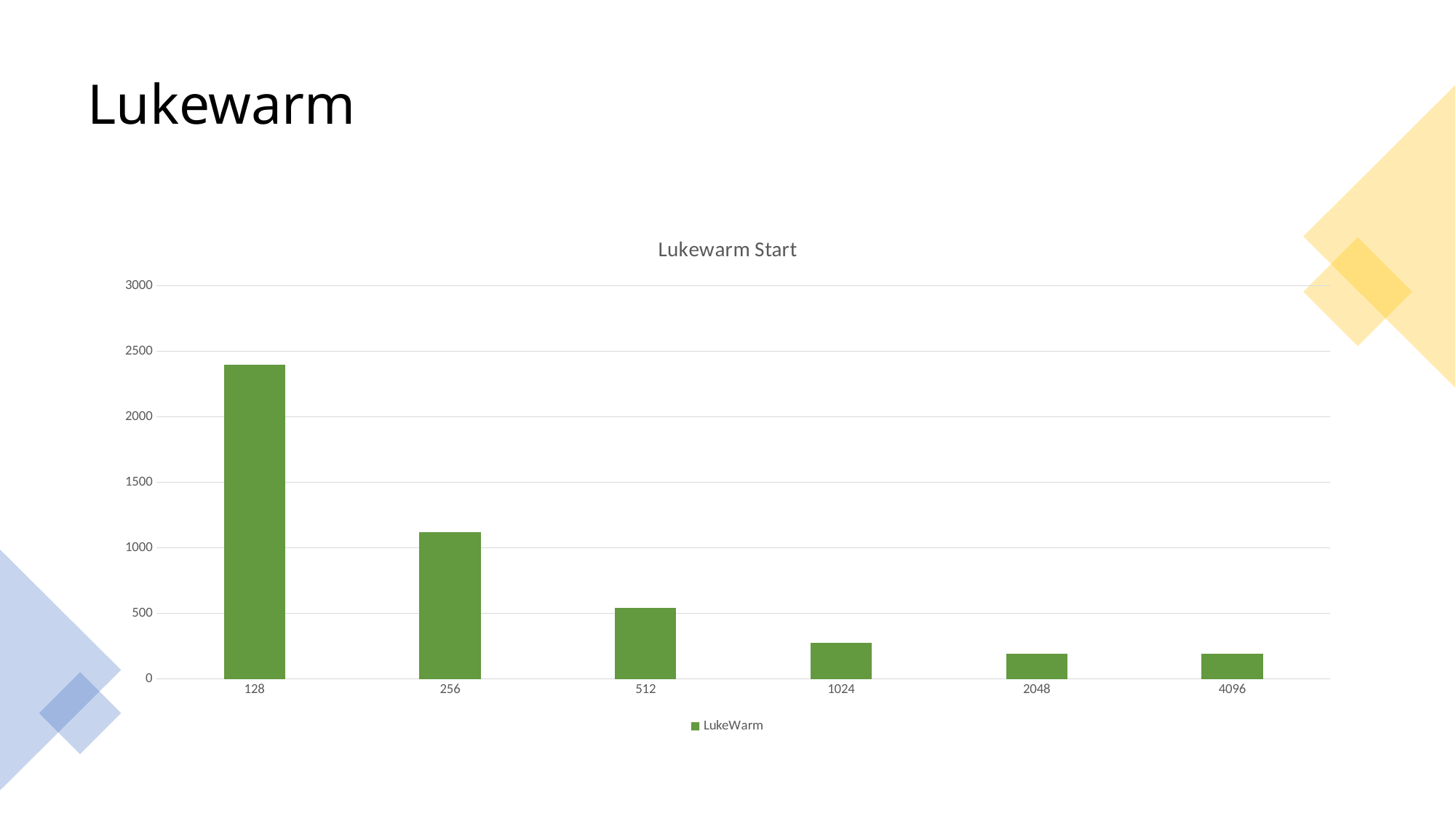
How many series does the legend list? 1 Is the value for 128 greater or less than 2000? greater What is the title of the chart? Lukewarm Start Is the value for 512 greater or less than 1000? less Which is larger, the value for 256 or the value for 512? 256 Which category has the highest value? 128 Is the value for 256 greater or less than 1000? greater What is the name of the series in the legend? LukeWarm What kind of chart is shown on the slide? bar chart Do the values rise or fall as you move from 128 to 4096 along the x axis? fall How many categories are shown on the x axis? 6